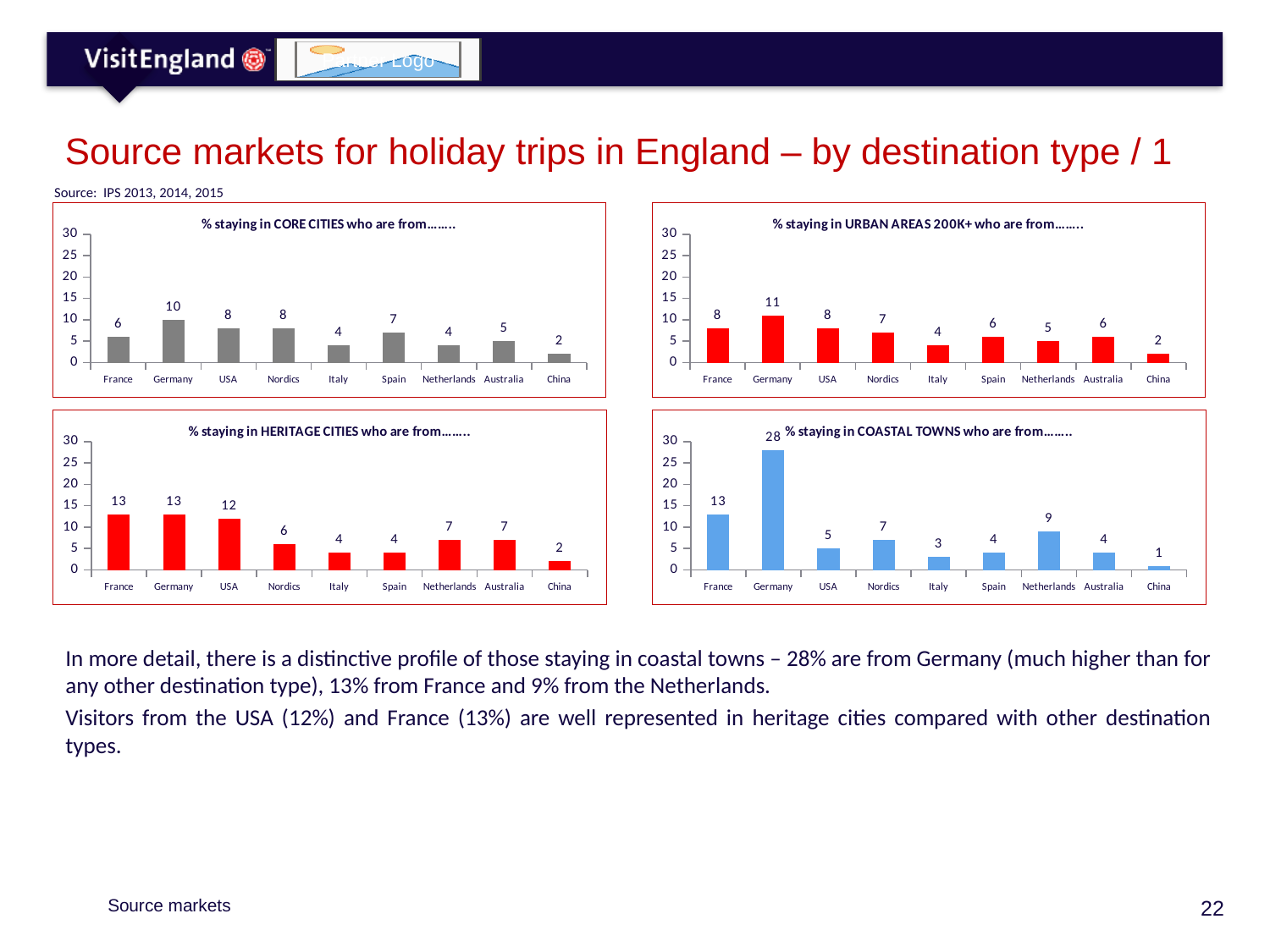
What kind of chart is the '% staying in HERITAGE CITIES who are from……..' chart? bar chart In the '% staying in COASTAL TOWNS who are from……..' chart, what is the value for Germany? 28 In the '% staying in HERITAGE CITIES who are from……..' chart, what is the difference between the values for France and Nordics? 7 In the '% staying in CORE CITIES who are from……..' chart, what is the value for Germany? 10 In the '% staying in CORE CITIES who are from……..' chart, which country has the lowest value? China In the '% staying in URBAN AREAS 200K+ who are from……..' chart, which country has the highest value? Germany In the '% staying in HERITAGE CITIES who are from……..' chart, what is the value for USA? 12 How many countries are shown on the x axis of the '% staying in CORE CITIES who are from……..' chart? 9 In the '% staying in URBAN AREAS 200K+ who are from……..' chart, what is the value for Nordics? 7 In the '% staying in URBAN AREAS 200K+ who are from……..' chart, what is the difference between the values for Germany and Italy? 7 In the '% staying in COASTAL TOWNS who are from……..' chart, is the value for Netherlands larger or smaller than the value for Australia? larger In the '% staying in COASTAL TOWNS who are from……..' chart, which country has the lowest value? China